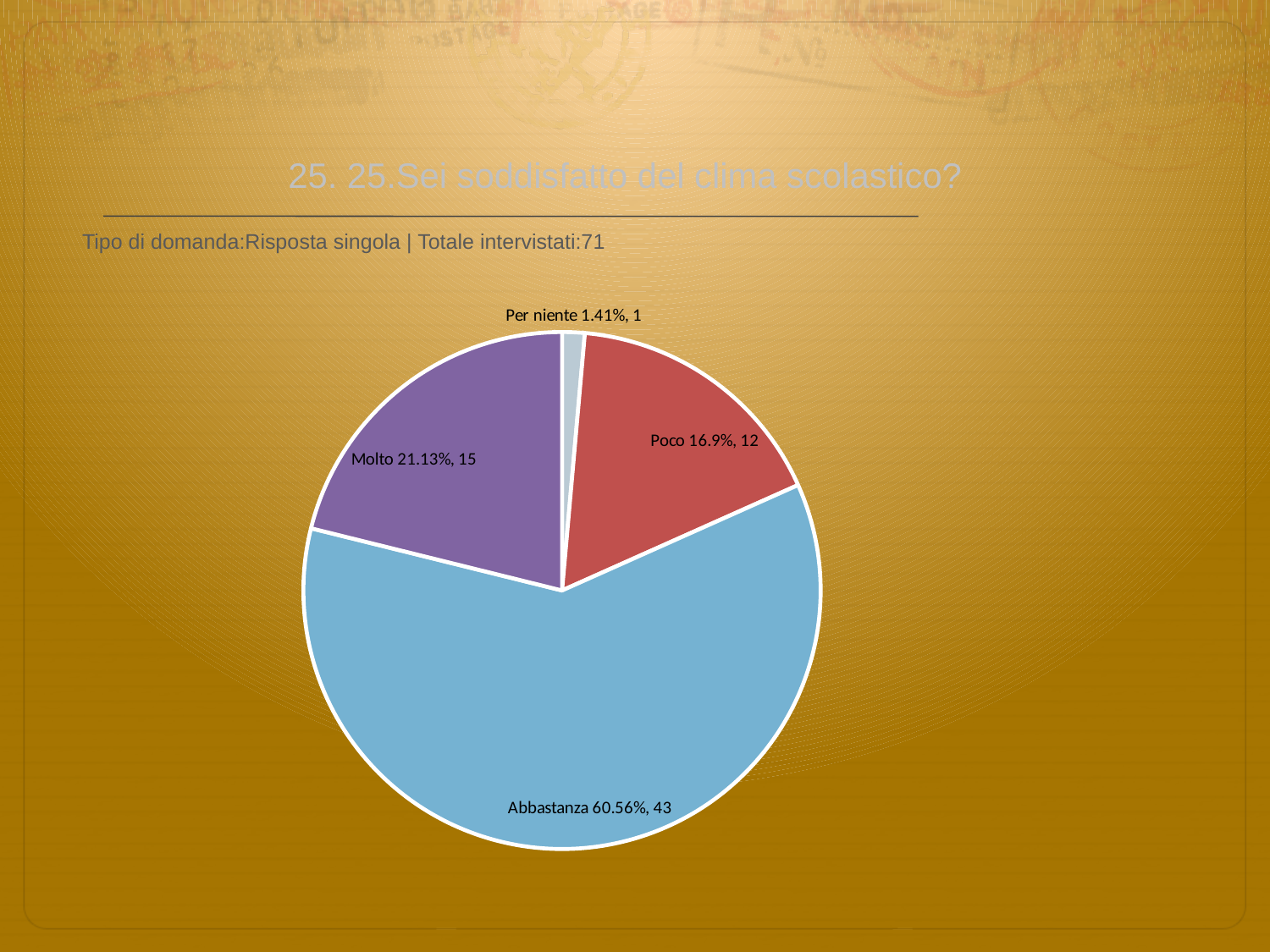
What percentage share does the Abbastanza slice have? 60.56% How many slices does the pie chart have? 4 Which category has the largest slice? Abbastanza What colour is the Abbastanza slice? Light blue What percentage share does the Per niente slice have? 1.41% Which has more respondents, Molto or Poco? Molto What is the total number of respondents shown across all slices? 71 What is the difference in respondent count between Abbastanza and Molto? 28 Which category has the smallest slice? Per niente How many respondents answered Poco? 12 What kind of chart is shown on the slide? Pie chart How many respondents answered Molto? 15